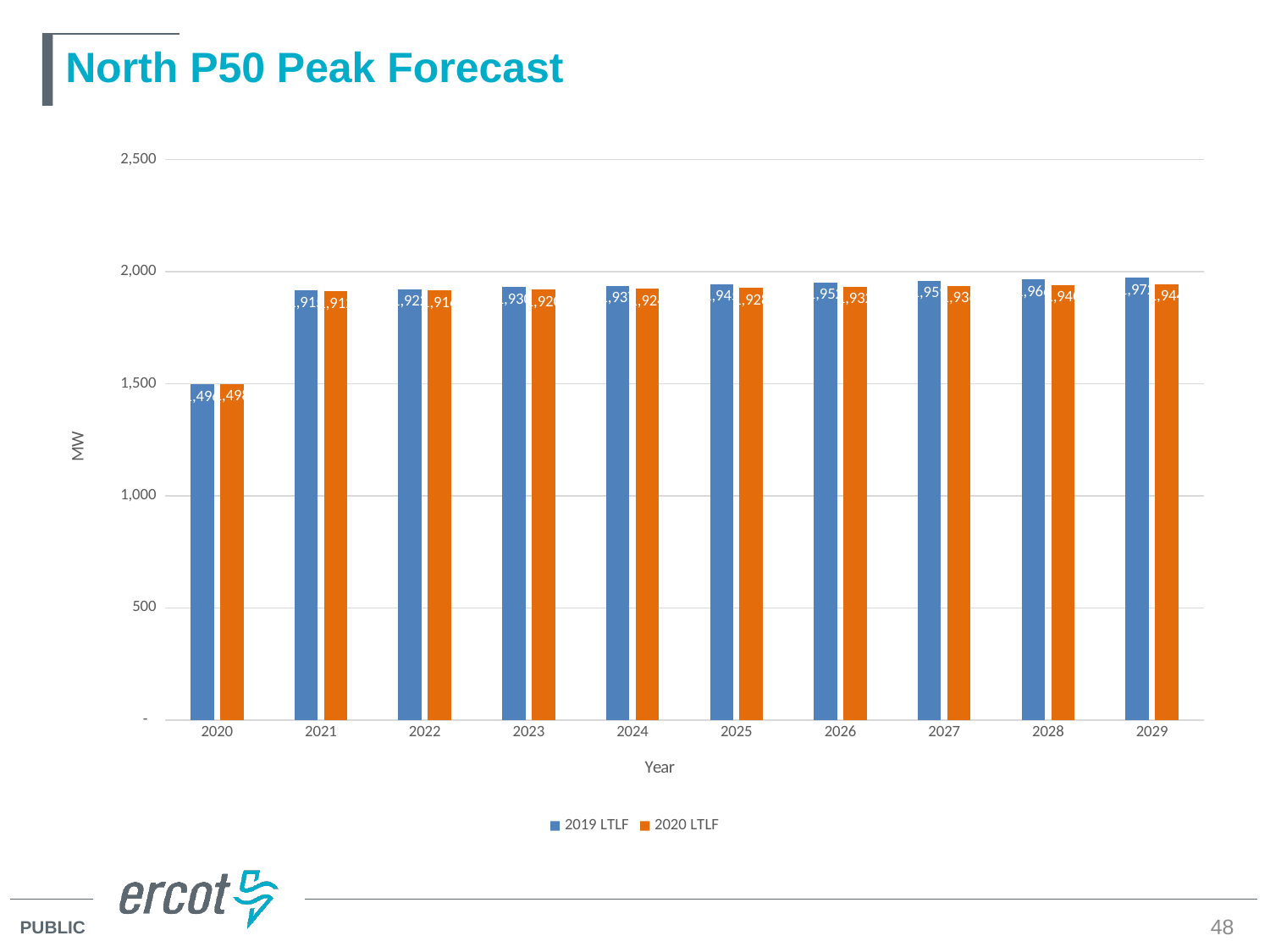
Is the 2020 LTLF value for 2025 greater or less than 2,000? less Which is larger, the 2019 LTLF value for 2020 or the 2019 LTLF value for 2021? 2021 Is the 2019 LTLF value for 2029 greater or less than 1,500? greater Is the 2020 LTLF value for 2020 greater or less than 1,000? greater How many series does the legend list? 2 What is the title of the chart? North P50 Peak Forecast Do the 2019 LTLF values generally rise or fall from 2020 to 2029? rise Which year has the lowest values for both series? 2020 What kind of chart is shown on the slide? bar chart What is the label on the y axis? MW How many years are shown on the x axis? 10